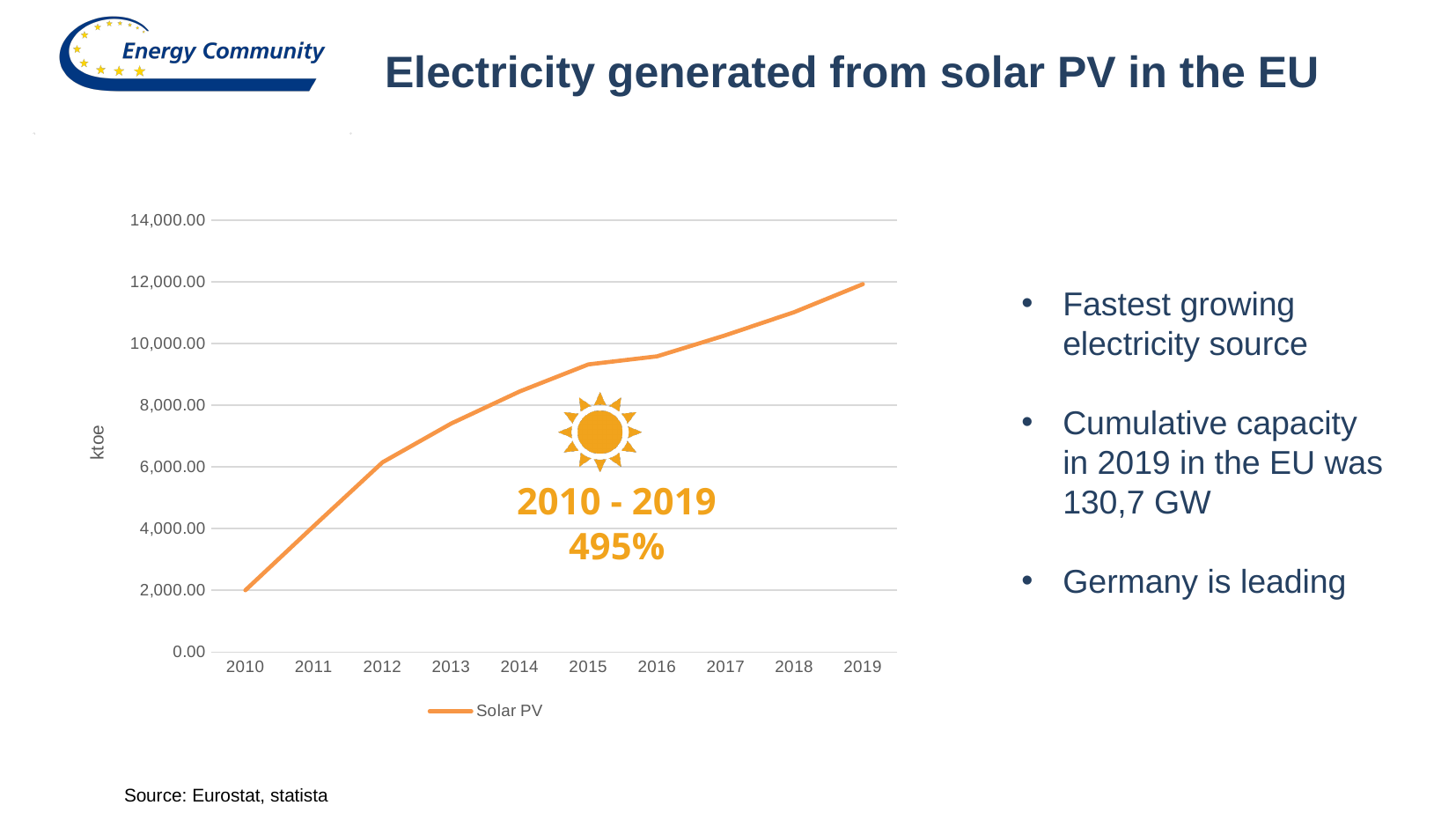
How many series does the legend list? 1 Do the Solar PV values rise or fall from 2010 to 2019? rise Which year has the larger Solar PV value, 2012 or 2018? 2018 Is the value for Solar PV in 2019 greater or less than 10,000.00? greater What kind of chart is shown on the slide? line chart Is the value for Solar PV in 2015 greater or less than 8,000.00? greater Is the value for Solar PV in 2010 greater or less than 4,000.00? less How many years are plotted along the x axis? 10 Which year has the lowest value for Solar PV? 2010 What unit is shown on the y axis of the chart? ktoe Which year has the highest value for Solar PV? 2019